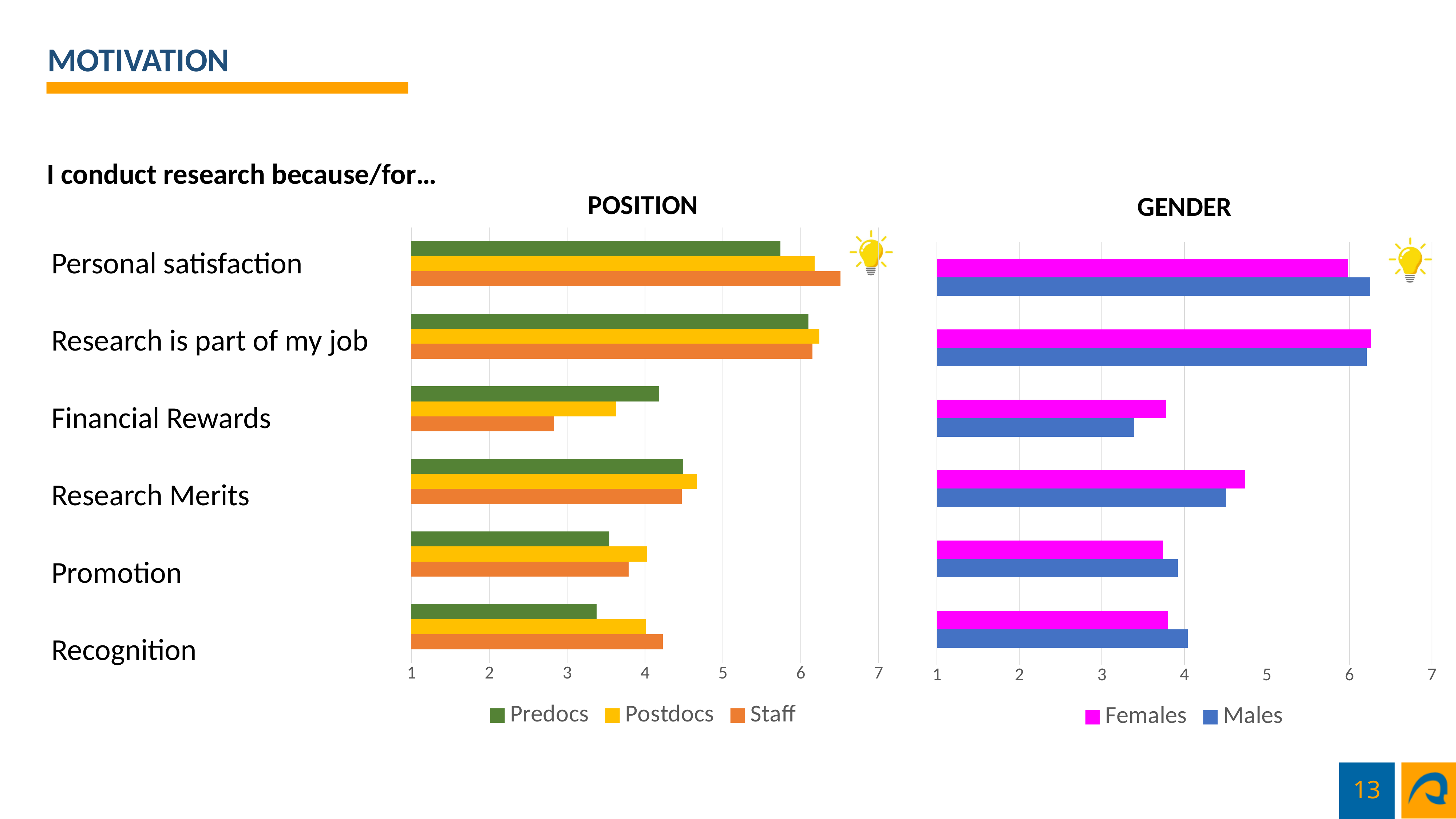
On the GENDER chart, which is larger for Financial Rewards: Females or Males? Females On the GENDER chart, which series is shown in magenta? Females On the POSITION chart, is the Staff value for Personal satisfaction greater or less than 6? greater How many categories are shown on the GENDER chart? 6 On the GENDER chart, is the Males value for Financial Rewards greater or less than 4? less How many series does the legend of the GENDER chart list? 2 On the POSITION chart, which is larger for Financial Rewards: Predocs or Staff? Predocs On the GENDER chart, is the Females value for Research Merits greater or less than 4? greater What type of chart is the POSITION chart? bar chart On the POSITION chart, which category has the lowest Staff value? Financial Rewards How many series does the legend of the POSITION chart list? 3